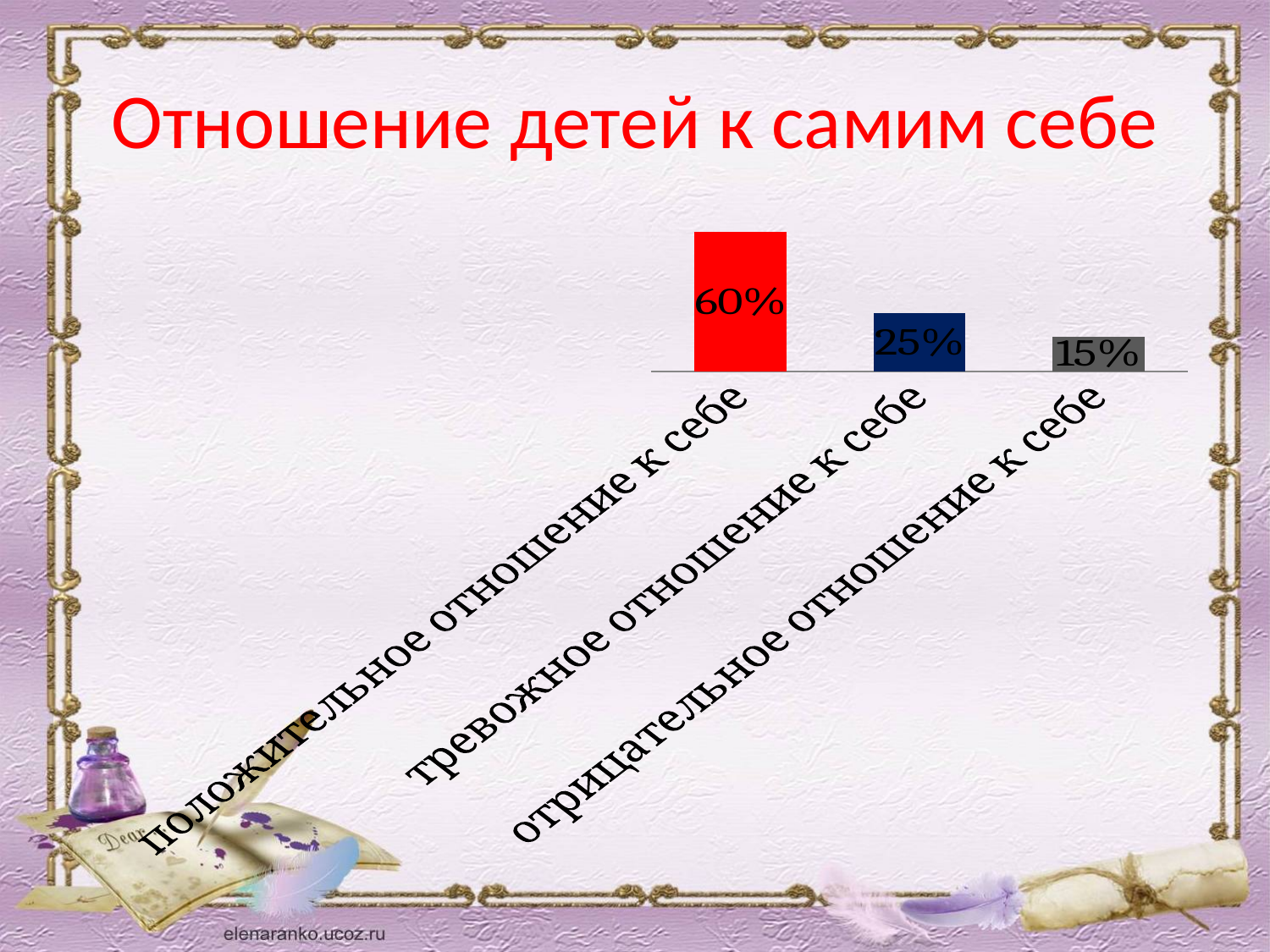
What is the difference between the values for "тревожное отношение к себе" and "отрицательное отношение к себе"? 10% What value is shown for "тревожное отношение к себе"? 25% Which is larger, the value for "тревожное отношение к себе" or "отрицательное отношение к себе"? тревожное отношение к себе What kind of chart is shown on the slide? bar chart Which category has the highest value? положительное отношение к себе What is the difference between the values for "положительное отношение к себе" and "тревожное отношение к себе"? 35% Do the values rise or fall from left to right across the categories? fall What is the title of the slide? Отношение детей к самим себе Which category has the lowest value? отрицательное отношение к себе What value is shown for "отрицательное отношение к себе"? 15% How many categories are shown in the chart? 3 What value is shown for "положительное отношение к себе"? 60%